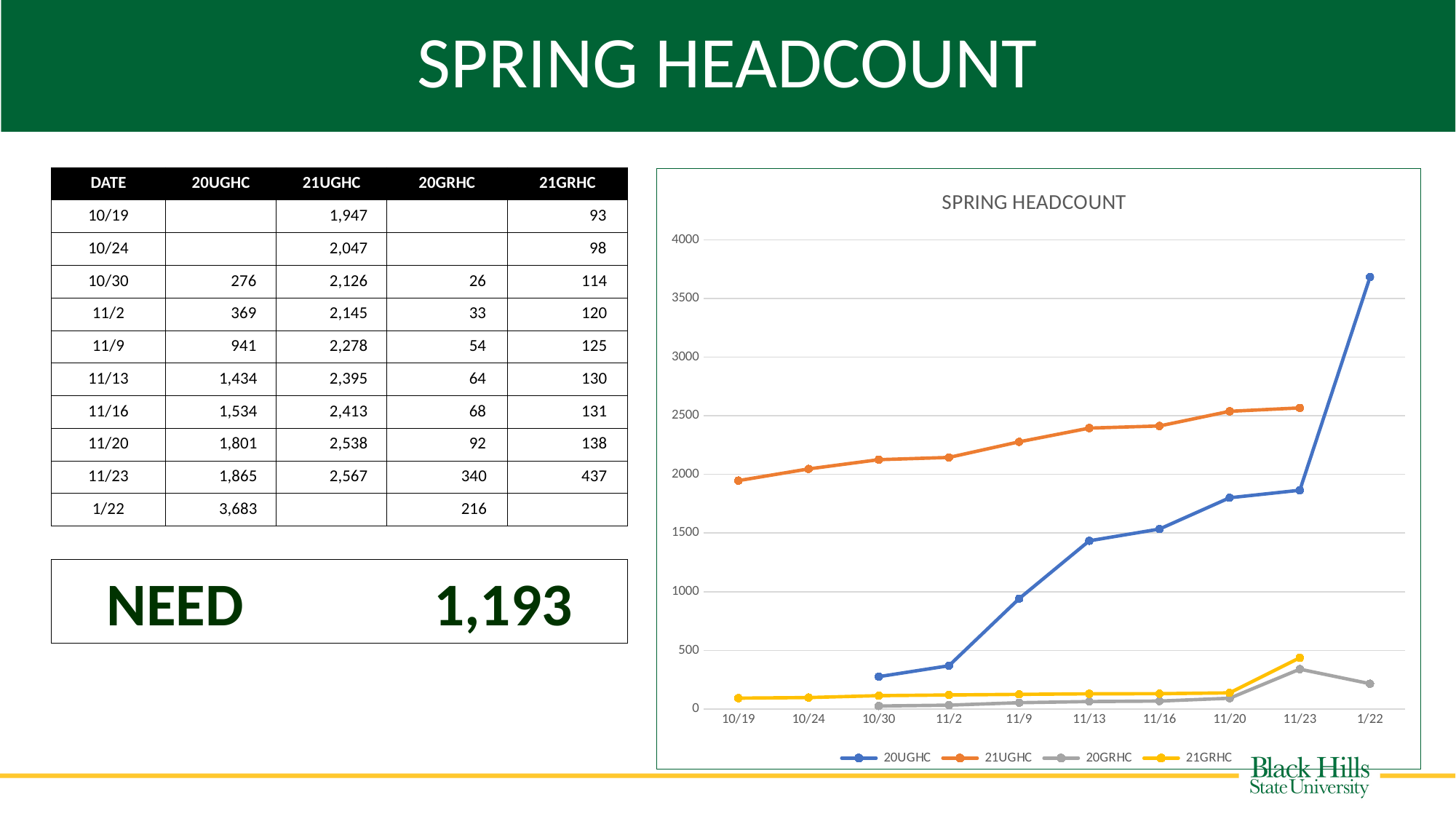
Is the 21UGHC value on 11/23 greater or less than 2500? greater Which series has the highest value on 11/16? 21UGHC Does the 21UGHC series rise or fall from 10/19 to 11/23? rise What is the title of the chart? SPRING HEADCOUNT On 11/23, which is larger: the 20UGHC value or the 21UGHC value? 21UGHC Which series has the lowest value on 11/2? 20GRHC How many dates are plotted along the x axis of the chart? 10 Is the 20UGHC value on 11/9 greater or less than 1000? less Is the 20UGHC value on 1/22 greater or less than 3500? greater How many series does the chart legend list? 4 What type of chart is shown on the slide? line chart Which series is shown in orange in the chart? 21UGHC